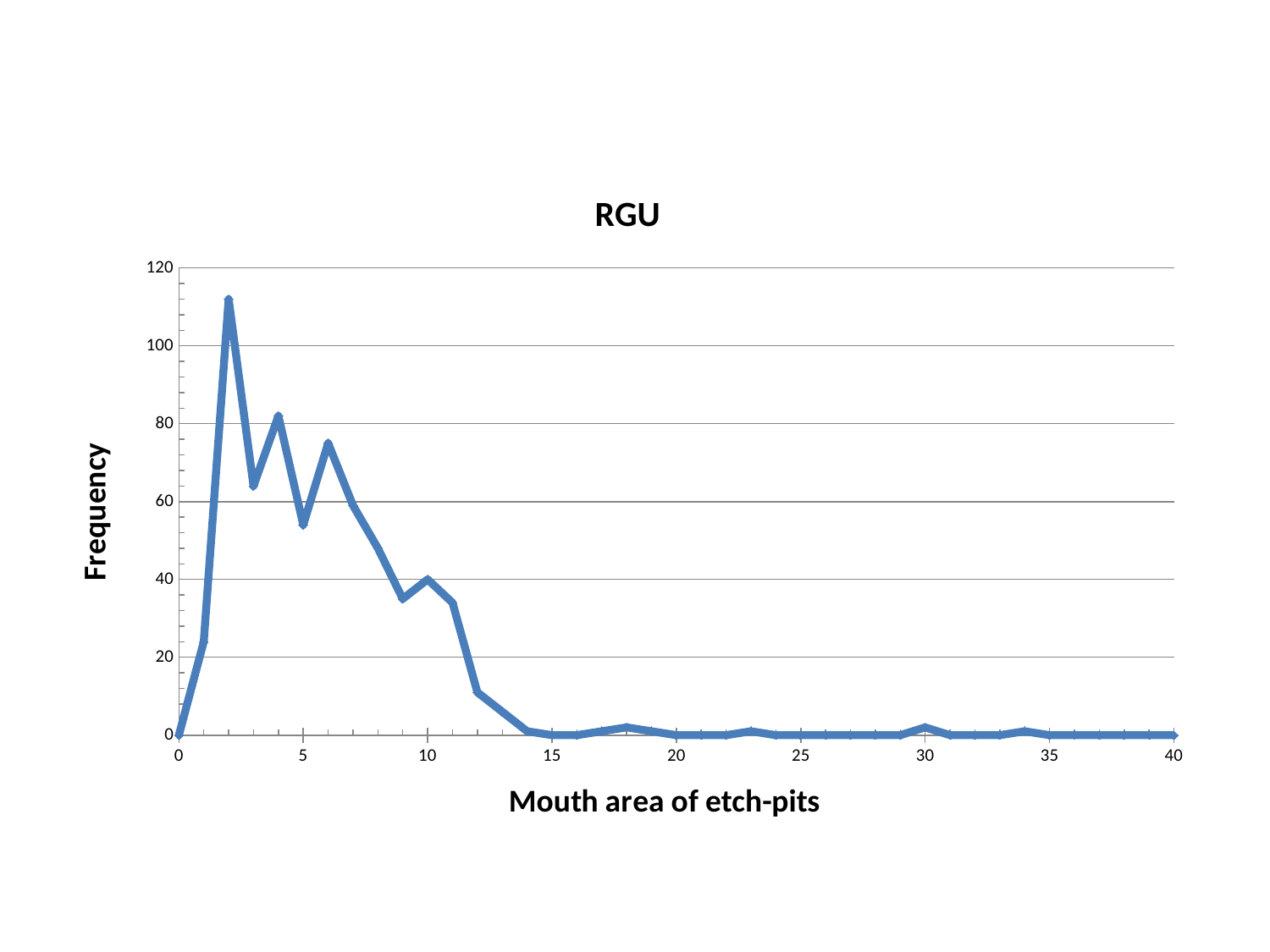
At which mouth area value does the frequency reach its highest point? 2 Does the frequency generally rise or fall as the mouth area increases from 6 to 14? fall Is the frequency at mouth area 4 greater or less than 100? less What is the label of the vertical axis? Frequency Is the frequency at mouth area 10 greater or less than 60? less Is the frequency at mouth area 6 greater or less than 60? greater What kind of chart is shown on the slide? line chart What is the title of the chart? RGU Which has the higher frequency, mouth area 9 or mouth area 10? mouth area 10 Which has the higher frequency, mouth area 2 or mouth area 6? mouth area 2